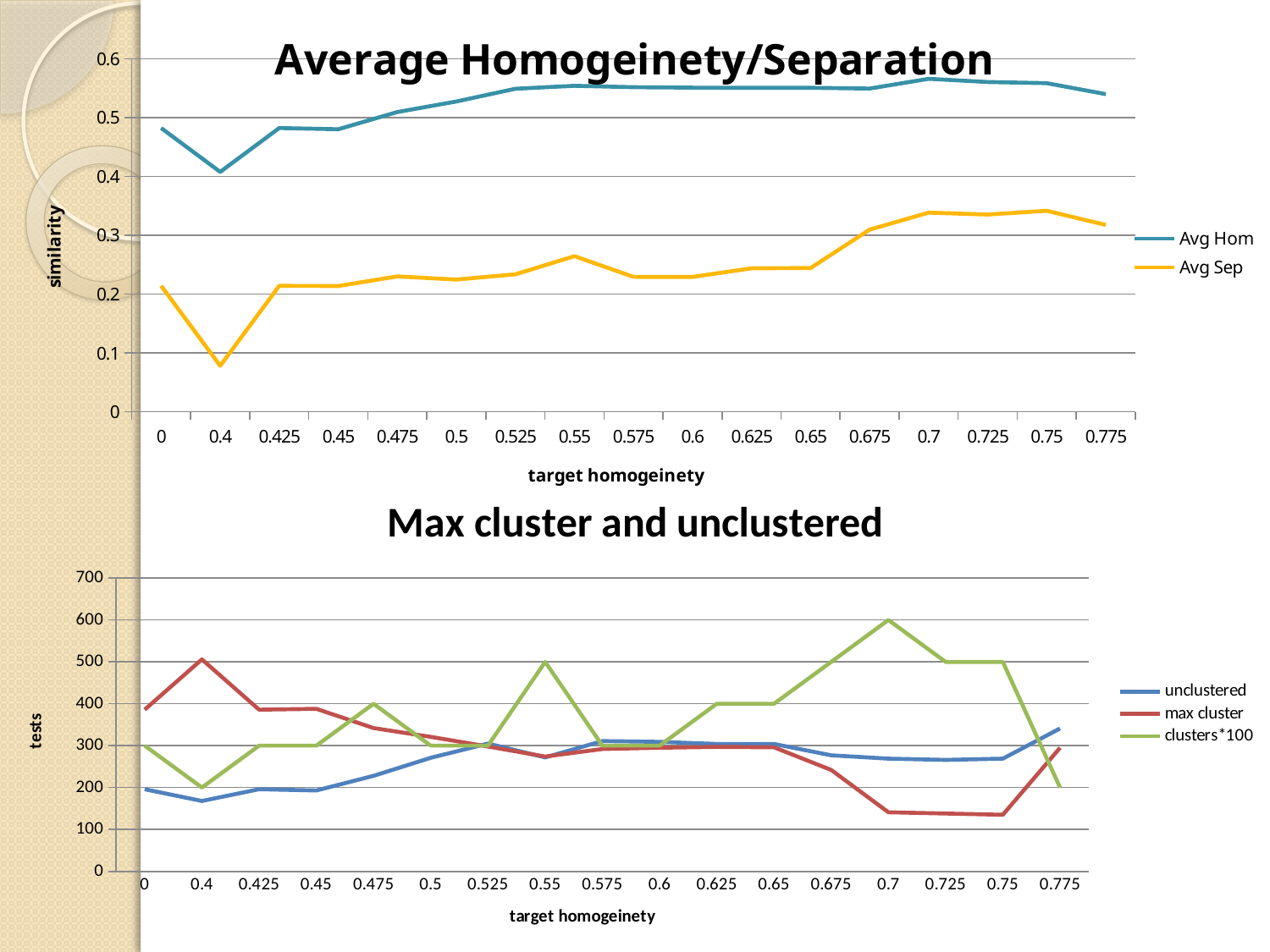
How many target homogeinety values are shown on the x axis of the 'Max cluster and unclustered' chart? 17 In the 'Max cluster and unclustered' chart, which series has the larger value at target homogeinety 0.7, unclustered or max cluster? unclustered In the 'Max cluster and unclustered' chart, is the unclustered value at target homogeinety 0.4 greater or less than 200? less How many series does the legend of the 'Max cluster and unclustered' chart list? 3 What type of chart is the 'Average Homogeinety/Separation' chart? line chart In the 'Max cluster and unclustered' chart, at which target homogeinety value does the max cluster series reach its highest point? 0.4 How many series does the legend of the 'Average Homogeinety/Separation' chart list? 2 In the 'Max cluster and unclustered' chart, at which target homogeinety value does the clusters*100 series reach its highest point? 0.7 In the 'Average Homogeinety/Separation' chart, is the Avg Sep value at target homogeinety 0.7 greater or less than 0.3? greater In the 'Max cluster and unclustered' chart, what is the clusters*100 value at target homogeinety 0.7? 600 In the 'Average Homogeinety/Separation' chart, which series has the larger value at target homogeinety 0.55, Avg Hom or Avg Sep? Avg Hom In the 'Average Homogeinety/Separation' chart, is the Avg Hom value at target homogeinety 0.4 greater or less than 0.5? less